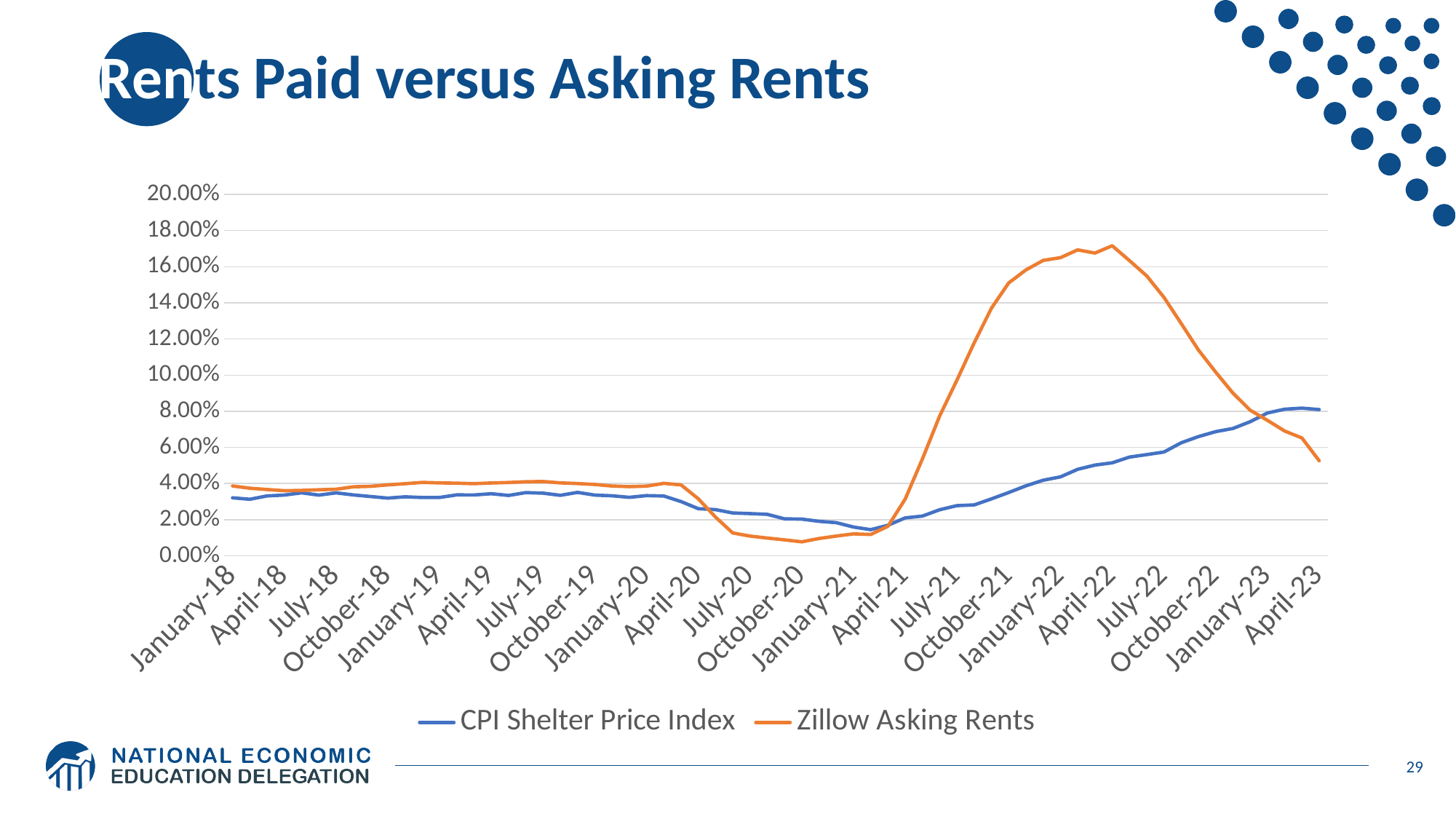
Does the Zillow Asking Rents line rise or fall between April-22 and April-23? fall Is the value for Zillow Asking Rents in October-20 greater or less than 2.00%? less In April-23, which series has the higher value, CPI Shelter Price Index or Zillow Asking Rents? CPI Shelter Price Index How many series does the legend list? 2 What is the title of the chart? Rents Paid versus Asking Rents Is the value for Zillow Asking Rents in April-22 greater or less than 16.00%? greater What kind of chart is shown on the slide? line chart Is the value for CPI Shelter Price Index in April-23 greater or less than 6.00%? greater Which series reaches the highest value anywhere on the chart? Zillow Asking Rents In April-22, which series has the higher value, CPI Shelter Price Index or Zillow Asking Rents? Zillow Asking Rents What are the two series named in the legend? CPI Shelter Price Index and Zillow Asking Rents